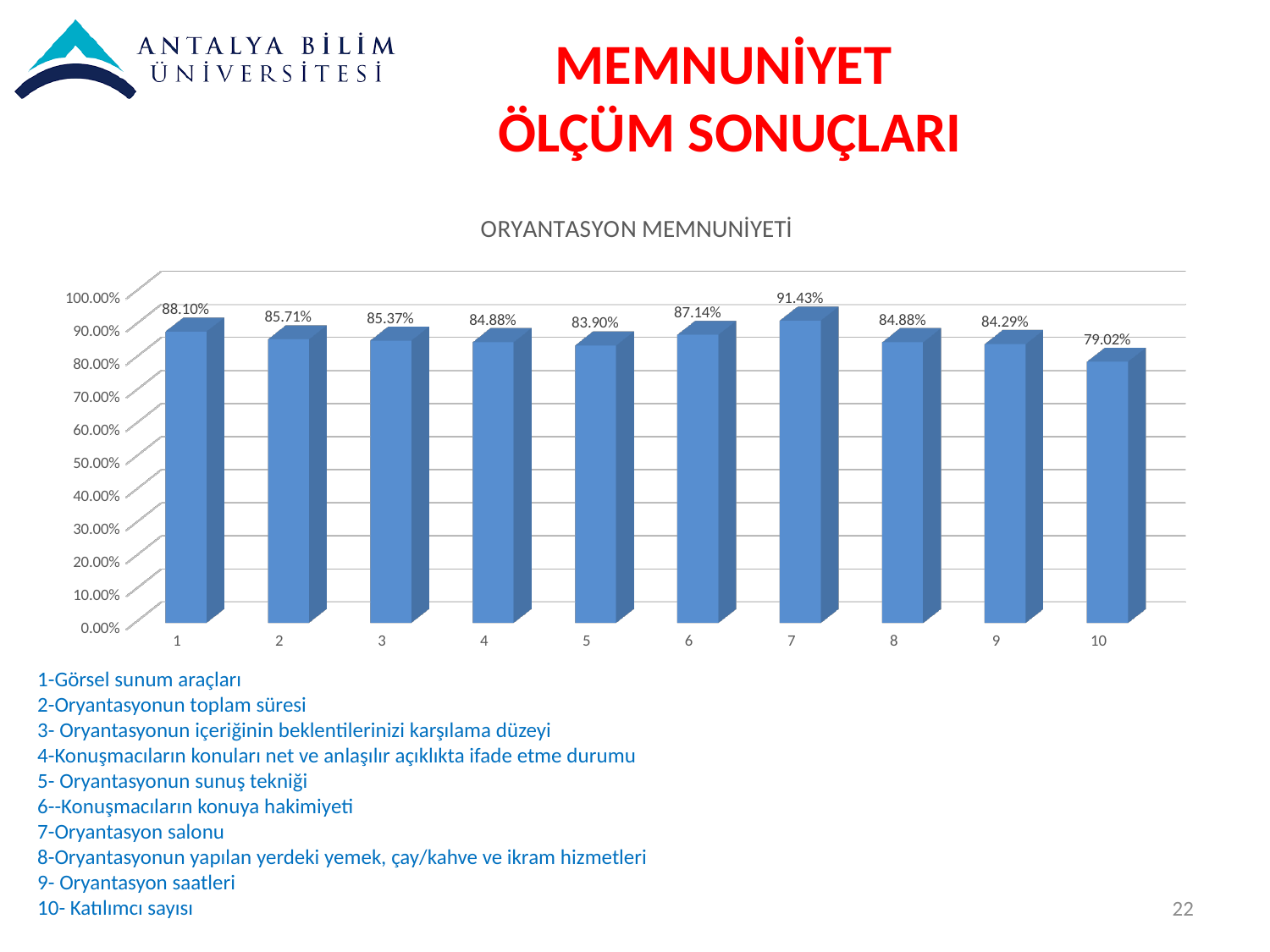
Which is larger, the value for category 1 or the value for category 6? category 1 What is the value for category 5 in the chart? 83.90% What is the value for category 7 in the chart? 91.43% How many categories are shown in the chart? 10 What is the title of the chart? ORYANTASYON MEMNUNİYETİ What is the difference between the values for category 7 and category 10? 12.41% What is the value for category 10 in the chart? 79.02% What is the value for category 1 in the chart? 88.10% Which category has the lowest value in the chart? 10 Which category has the highest value in the chart? 7 What kind of chart is shown on the slide? bar chart Is the value for category 10 greater or less than 80.00%? less